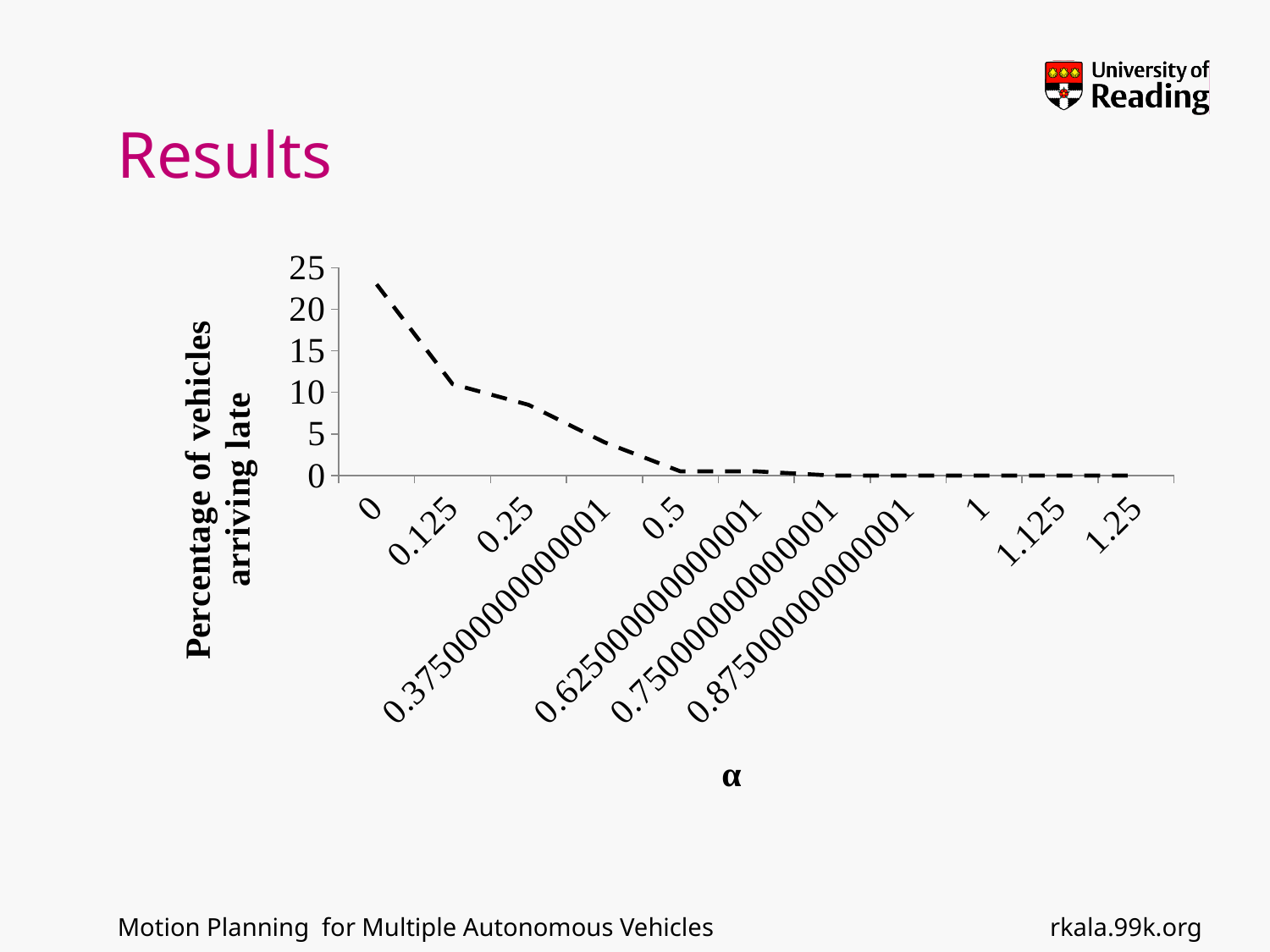
How many α values are labelled along the x axis of the chart? 11 Is the percentage of vehicles arriving late at α = 0.25 greater or less than 5? greater What is the label of the y axis of the chart? Percentage of vehicles arriving late Does the percentage of vehicles arriving late rise or fall as α increases along the x axis? fall Is the percentage of vehicles arriving late at α = 1 greater or less than 5? less Which has a higher percentage of vehicles arriving late, α = 0 or α = 0.25? 0 At which α value is the percentage of vehicles arriving late highest? 0 What is the label of the x axis of the chart? α Is the percentage of vehicles arriving late at α = 0.125 greater or less than 15? less What kind of chart is shown on the slide? line chart Which has a higher percentage of vehicles arriving late, α = 0.125 or α = 0.5? 0.125